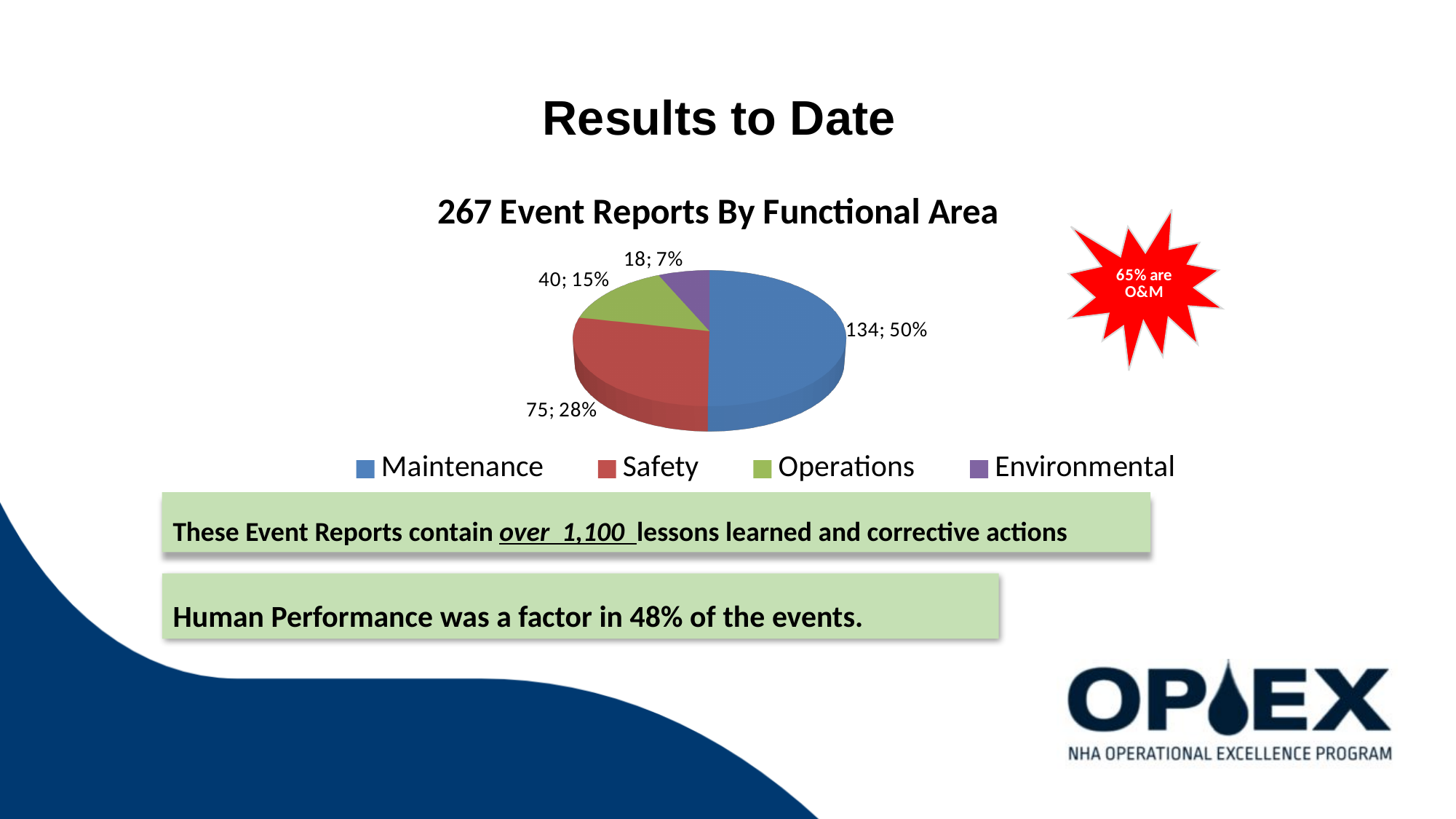
What kind of chart is shown on the slide? Pie chart What is the difference in event reports between Maintenance and Safety? 59 How many categories does the pie chart have? 4 Which functional area has the fewest event reports? Environmental What percentage of event reports are in the Safety category? 28% What share of the pie does Environmental represent? 7% What is the title of the chart? 267 Event Reports By Functional Area Which functional area has the largest number of event reports? Maintenance How many event reports are in the Operations category? 40 Which has more event reports, Operations or Environmental? Operations Which colour represents Safety in the pie chart? Red How many event reports are in the Maintenance category? 134